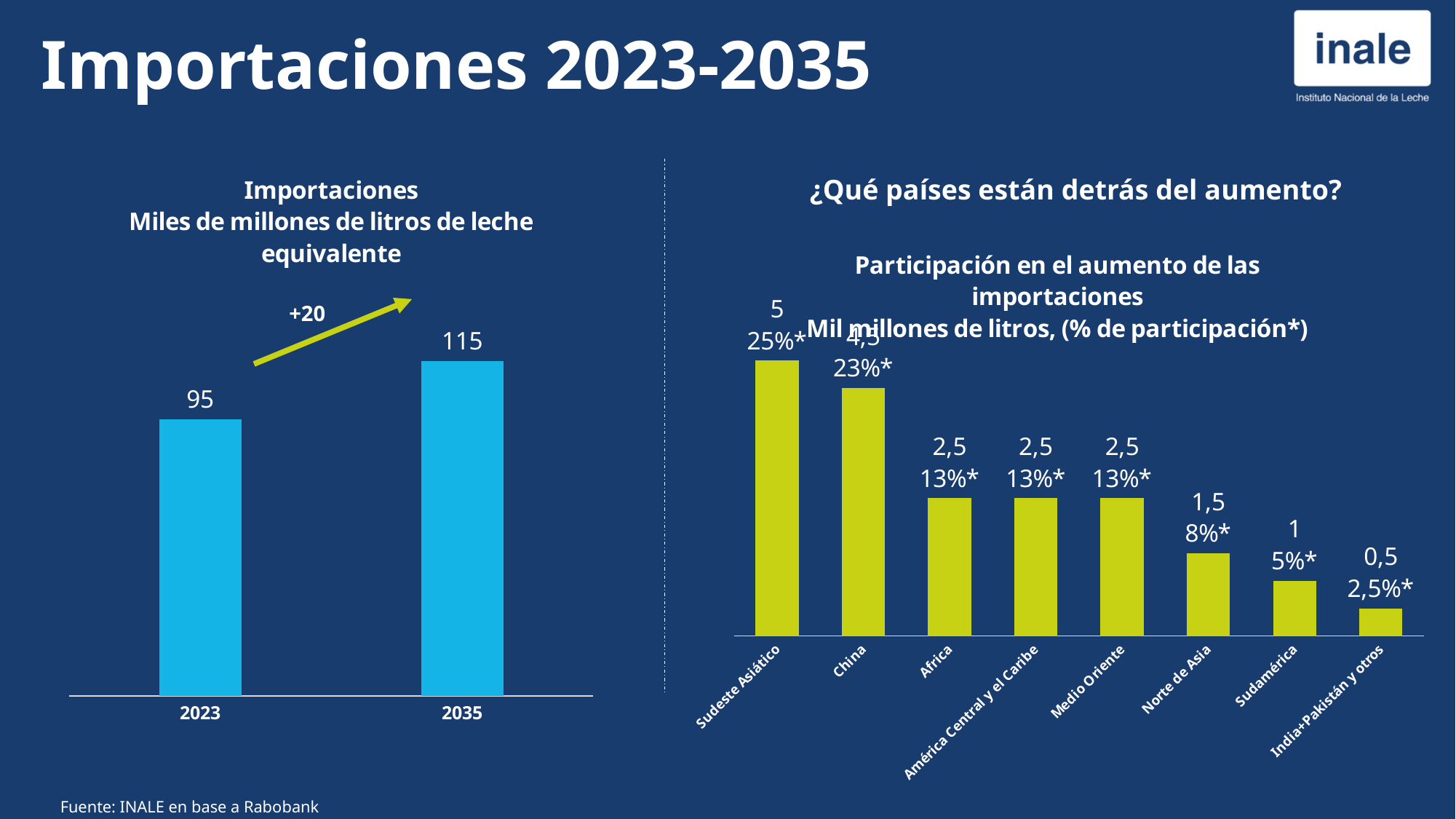
What kind of chart is the left chart (Importaciones)? bar chart In the left chart (Importaciones), what is the value for 2035? 115 In the right chart (Participación en el aumento de las importaciones), which is larger, the value for Medio Oriente or the value for Norte de Asia? Medio Oriente In the right chart (Participación en el aumento de las importaciones), which category has the highest value? Sudeste Asiático In the left chart (Importaciones), what is the value for 2023? 95 In the right chart (Participación en el aumento de las importaciones), how many categories are shown? 8 In the right chart (Participación en el aumento de las importaciones), what is the value for Sudeste Asiático in mil millones de litros? 5 In the left chart (Importaciones), do the values rise or fall from 2023 to 2035? rise In the right chart (Participación en el aumento de las importaciones), which category has the lowest value? India+Pakistán y otros In the left chart (Importaciones), what is the difference between the 2035 and 2023 values? 20 In the right chart (Participación en el aumento de las importaciones), what percentage share is shown for China? 23%* In the right chart (Participación en el aumento de las importaciones), what is the difference between the values for Norte de Asia and Sudamérica? 0,5